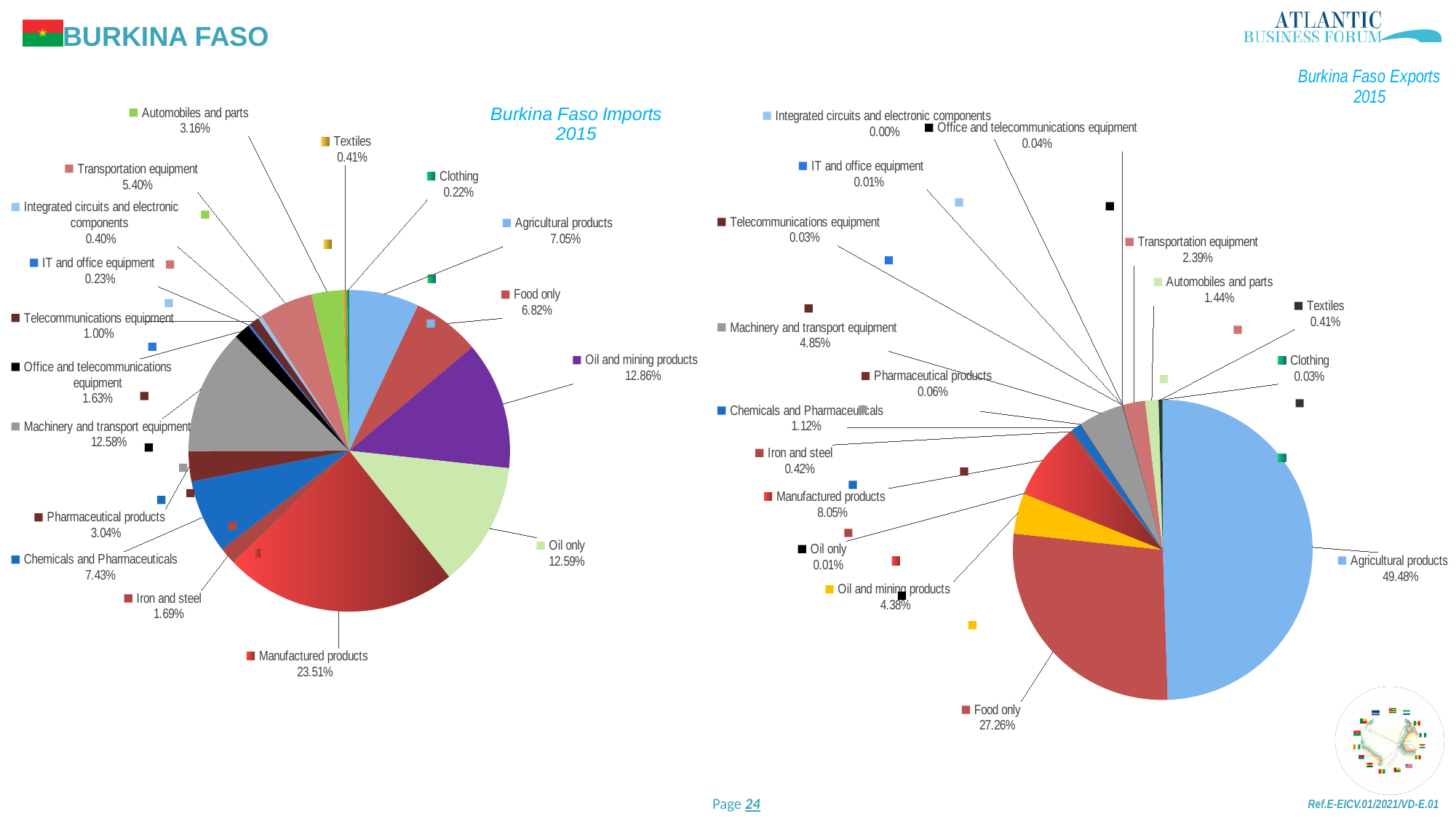
In the Burkina Faso Exports 2015 chart, what share do Agricultural products have? 49.48% What kind of chart is the Burkina Faso Imports 2015 chart? Pie chart How many categories are shown in the Burkina Faso Exports 2015 chart? 17 In the Burkina Faso Exports 2015 chart, which is larger: Machinery and transport equipment or Transportation equipment? Machinery and transport equipment In the Burkina Faso Imports 2015 chart, which category has the largest share? Manufactured products In the Burkina Faso Imports 2015 chart, what share do Manufactured products have? 23.51% In the Burkina Faso Imports 2015 chart, what is the difference between the shares of Oil and mining products and Oil only? 0.27% In the Burkina Faso Imports 2015 chart, which is larger: Agricultural products or Food only? Agricultural products In the Burkina Faso Imports 2015 chart, which category has the smallest share? Clothing In the Burkina Faso Exports 2015 chart, what is the difference between the shares of Manufactured products and Oil and mining products? 3.67% In the Burkina Faso Exports 2015 chart, what is the share of Food only? 27.26% In the Burkina Faso Exports 2015 chart, which category has the largest share? Agricultural products